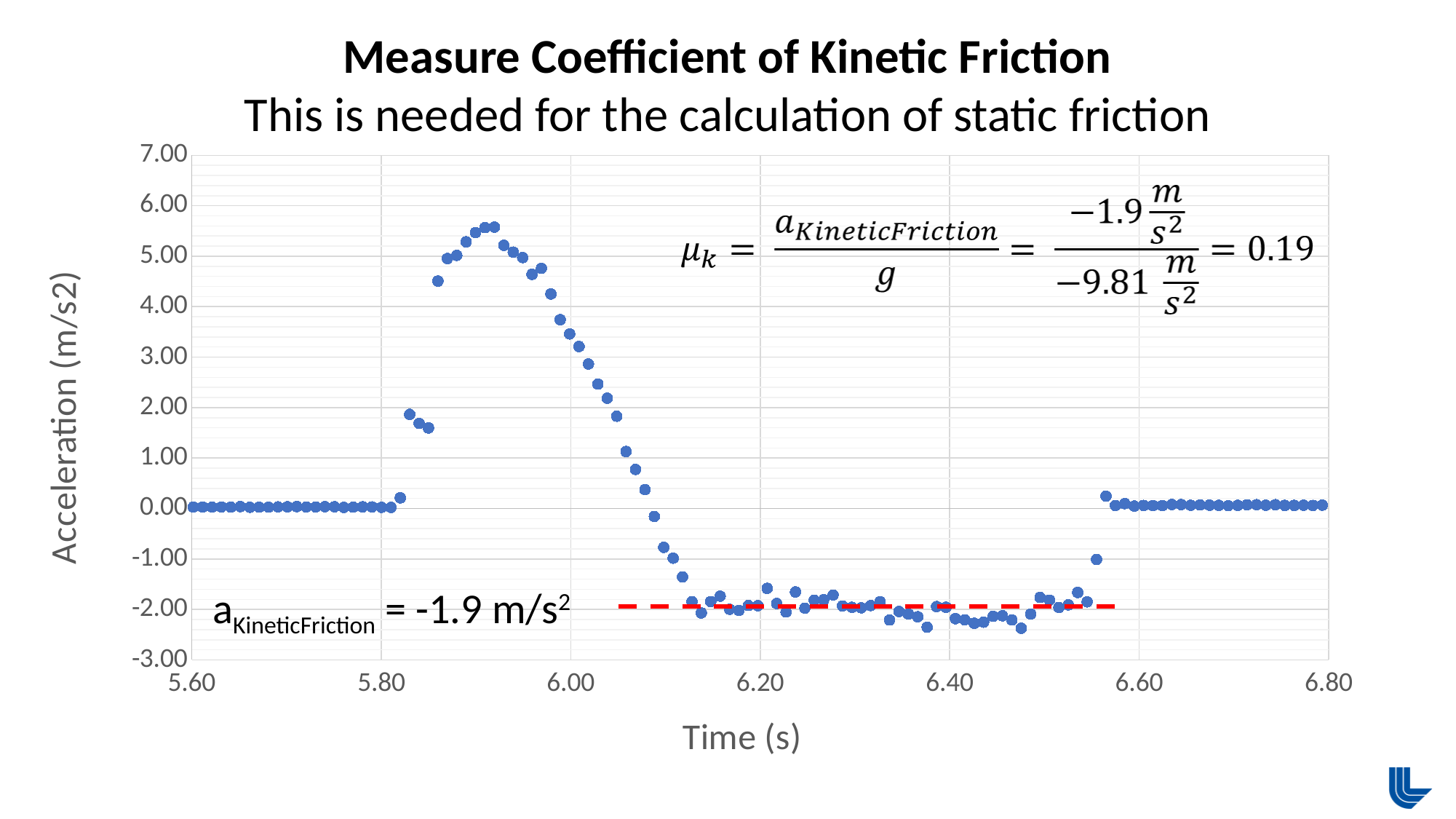
What is the label of the horizontal axis of the chart? Time (s) What value of a_KineticFriction is annotated on the chart? -1.9 m/s2 Is the acceleration at time 5.70 s greater or less than 1.00? less What is the highest value shown on the vertical axis of the chart? 7.00 Is the acceleration at time 6.00 s greater or less than 3.00? greater Which is larger, the acceleration at time 5.90 s or the acceleration at time 6.20 s? 5.90 s What kind of chart is shown on the slide? scatter chart Is the peak acceleration value on the chart greater or less than 5.00? greater What is the label of the vertical axis of the chart? Acceleration (m/s2) Between time 5.90 s and 6.10 s, do the acceleration values rise or fall? fall